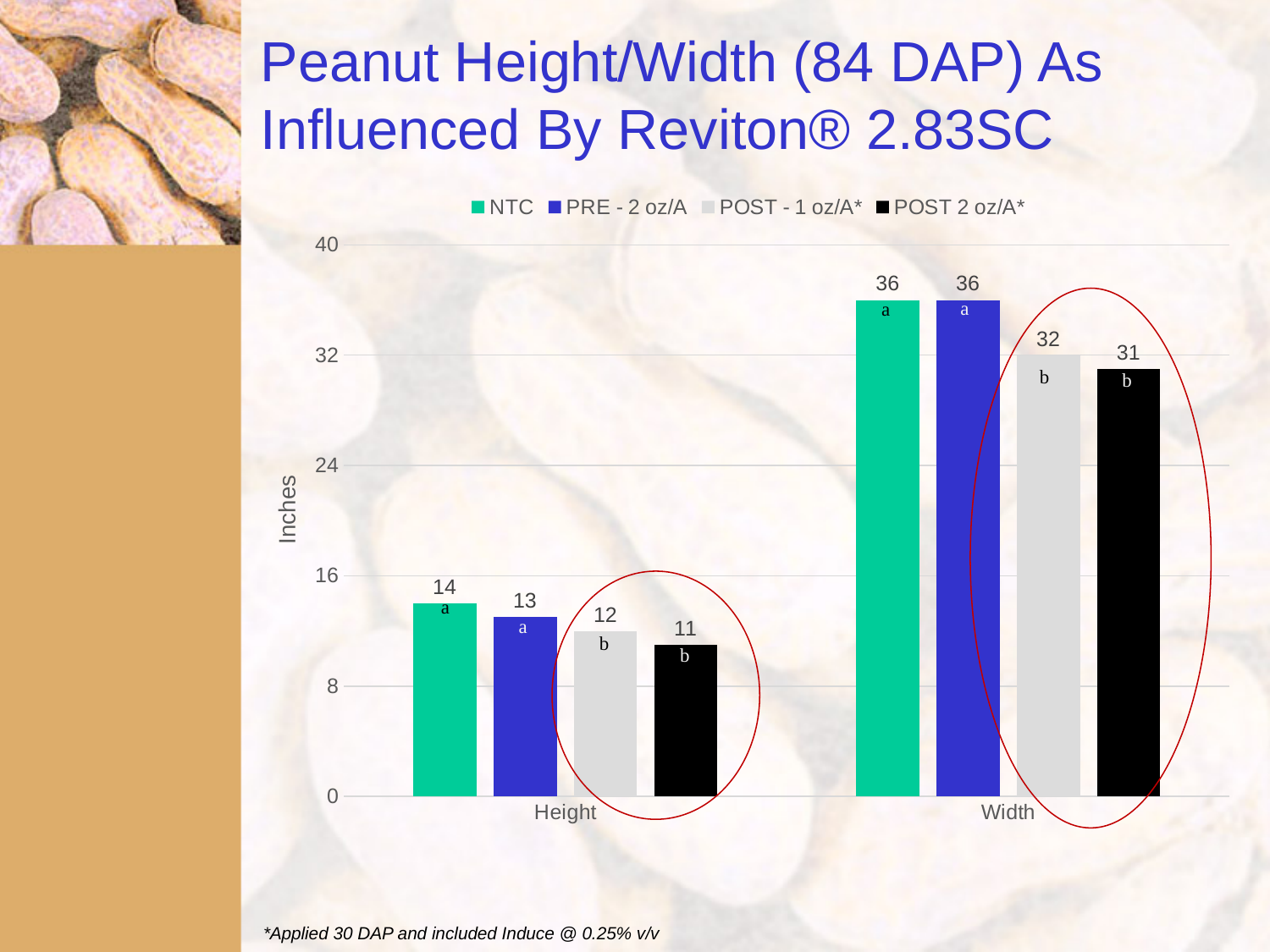
What is the Width value for PRE - 2 oz/A? 36 What kind of chart is shown on the slide? bar chart What is the Width value for POST 2 oz/A*? 31 What is the difference between the Width values for NTC and POST 2 oz/A*? 5 Which series has the lowest Height value? POST 2 oz/A* What is the difference between the Height values for NTC and POST - 1 oz/A*? 2 What is the Height value for POST - 1 oz/A*? 12 What is the Height value for NTC? 14 How many series does the legend list? 4 What is the label on the vertical axis? Inches Which is larger, the Height value for PRE - 2 oz/A or the Height value for POST 2 oz/A*? PRE - 2 oz/A How many categories are shown on the x axis? 2